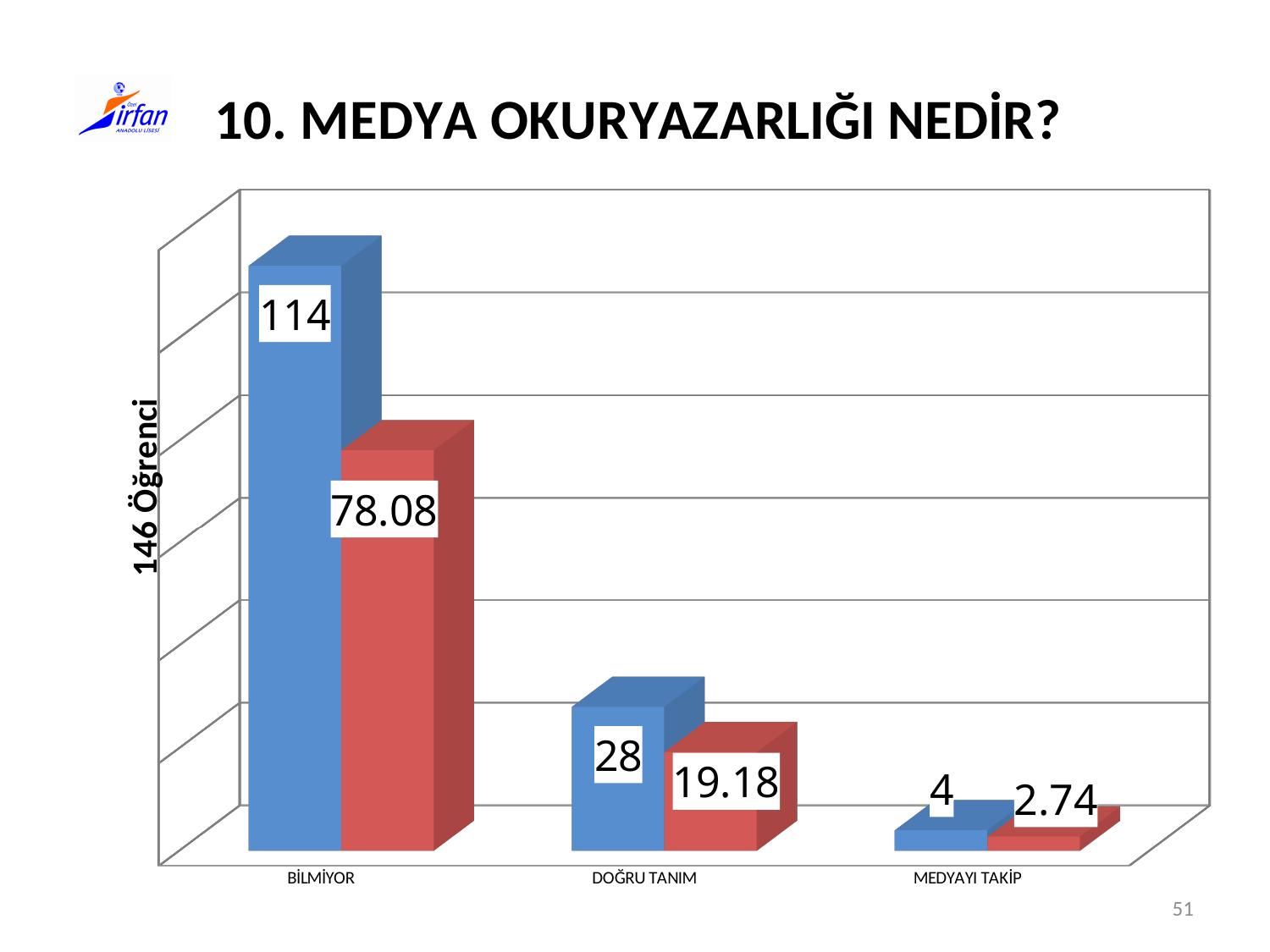
Which category has the lowest red bar? MEDYAYI TAKİP What kind of chart is shown on the slide? Bar chart How many categories are shown on the x axis? 3 What is the value of the blue bar for DOĞRU TANIM? 28 What is the value of the red bar for DOĞRU TANIM? 19.18 What is the value of the red bar for BİLMİYOR? 78.08 What is the value of the blue bar for MEDYAYI TAKİP? 4 What is the difference between the blue bars for BİLMİYOR and DOĞRU TANIM? 86 Which category has the highest blue bar? BİLMİYOR Which is larger: the blue bar for DOĞRU TANIM or the blue bar for MEDYAYI TAKİP? DOĞRU TANIM What is the value of the red bar for MEDYAYI TAKİP? 2.74 What is the value of the blue bar for BİLMİYOR? 114